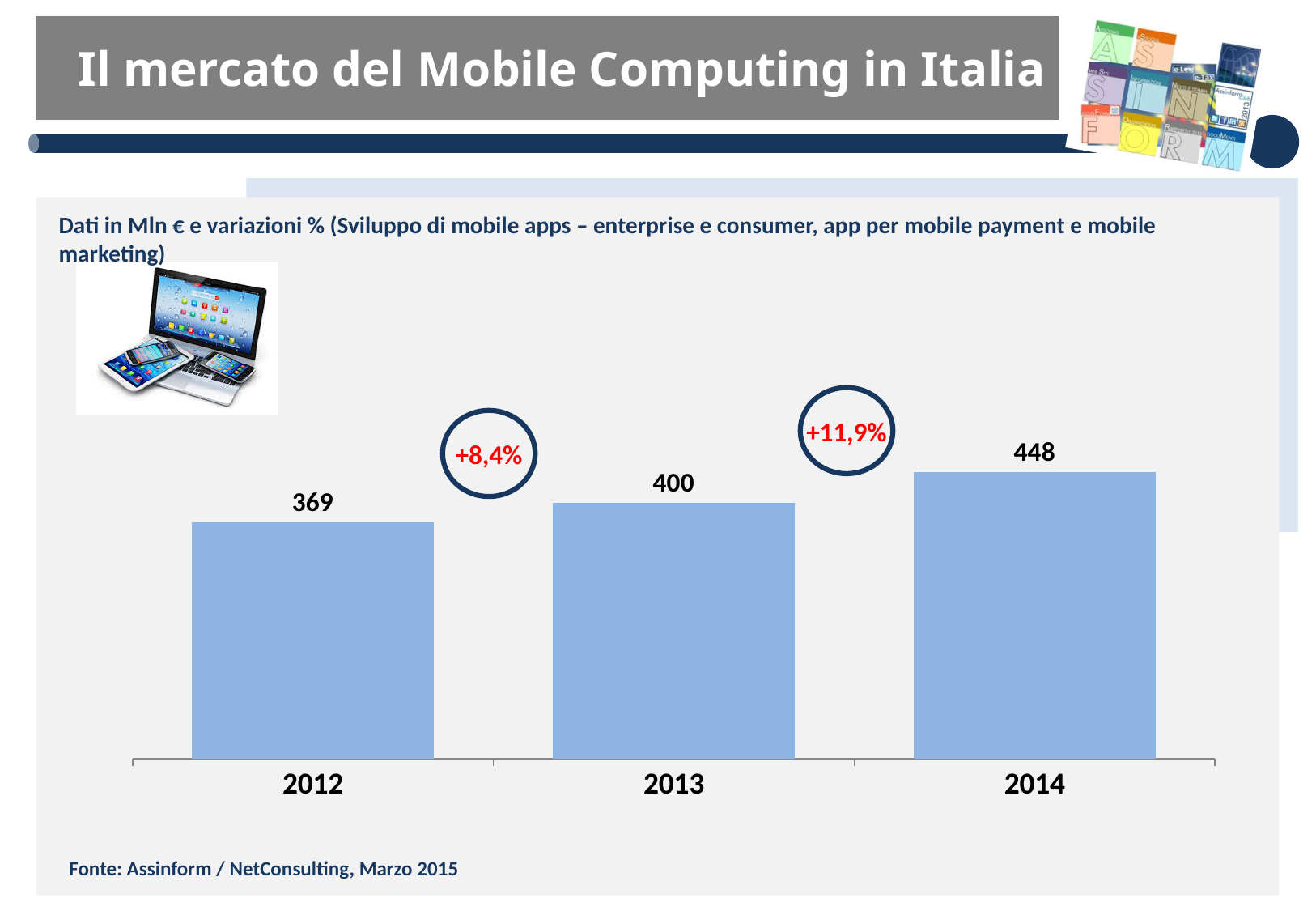
What is the difference between the values for 2013 and 2012? 31 Which year has the highest value? 2014 Which year has the lowest value? 2012 What is the value for 2014? 448 Do the values rise or fall from 2012 to 2014? rise What kind of chart is shown on the slide? bar chart What is the value for 2012? 369 How many years are shown on the x axis? 3 What is the value for 2013? 400 What is the difference between the values for 2014 and 2012? 79 Which is larger, the value for 2013 or the value for 2014? 2014 What percentage change is shown between 2013 and 2014? +11,9%